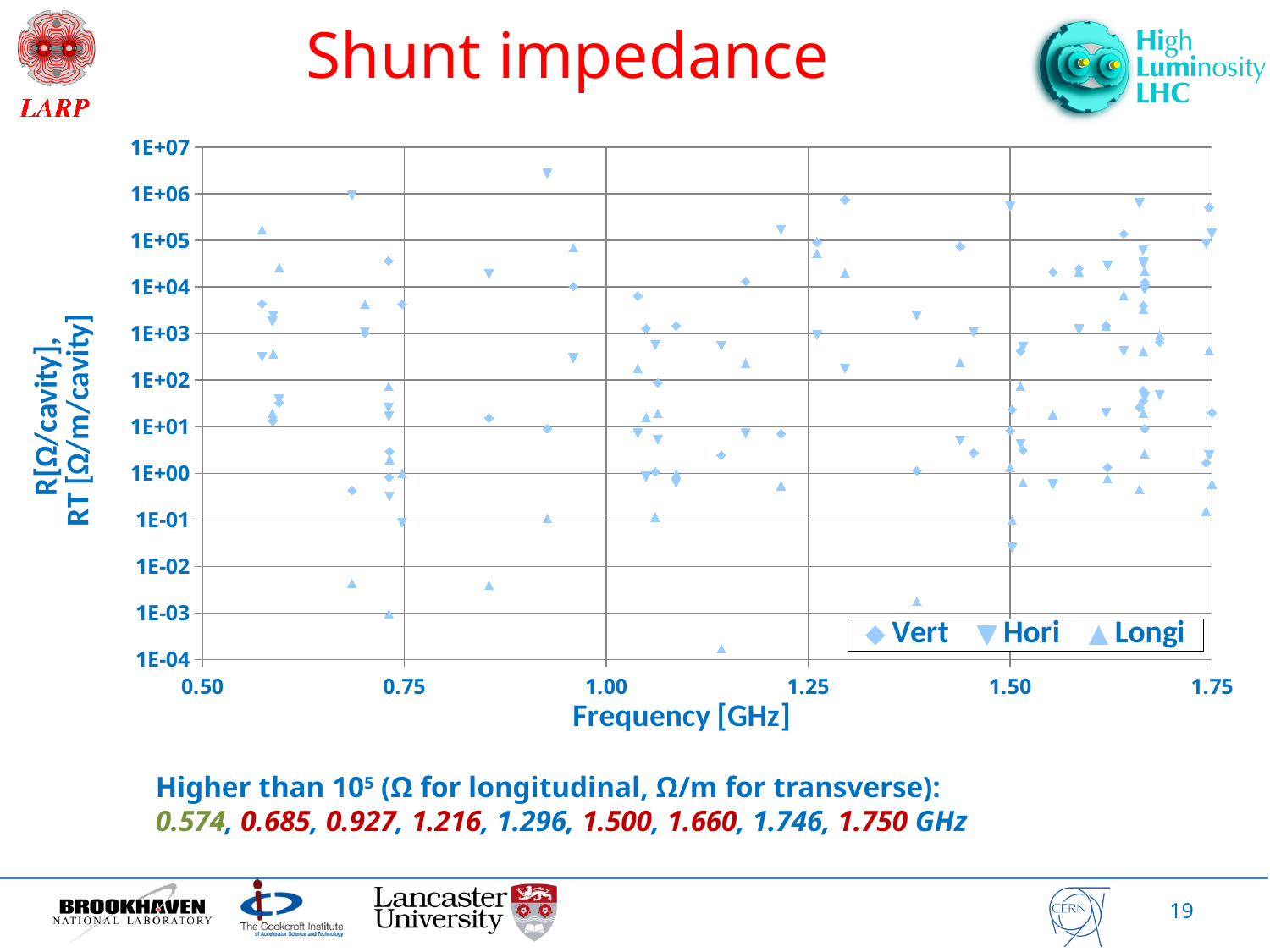
Is the highest plotted point on the chart greater or less than 1E+06? greater What kind of chart is shown on the slide? scatter chart Which series contains the highest plotted point on the chart? Hori Is the lowest plotted point on the chart greater or less than 1E-03? less What are the series names listed in the legend? Vert, Hori, Longi Which series contains the lowest plotted point on the chart? Longi What is the title of the x axis? Frequency [GHz] How many series does the legend list? 3